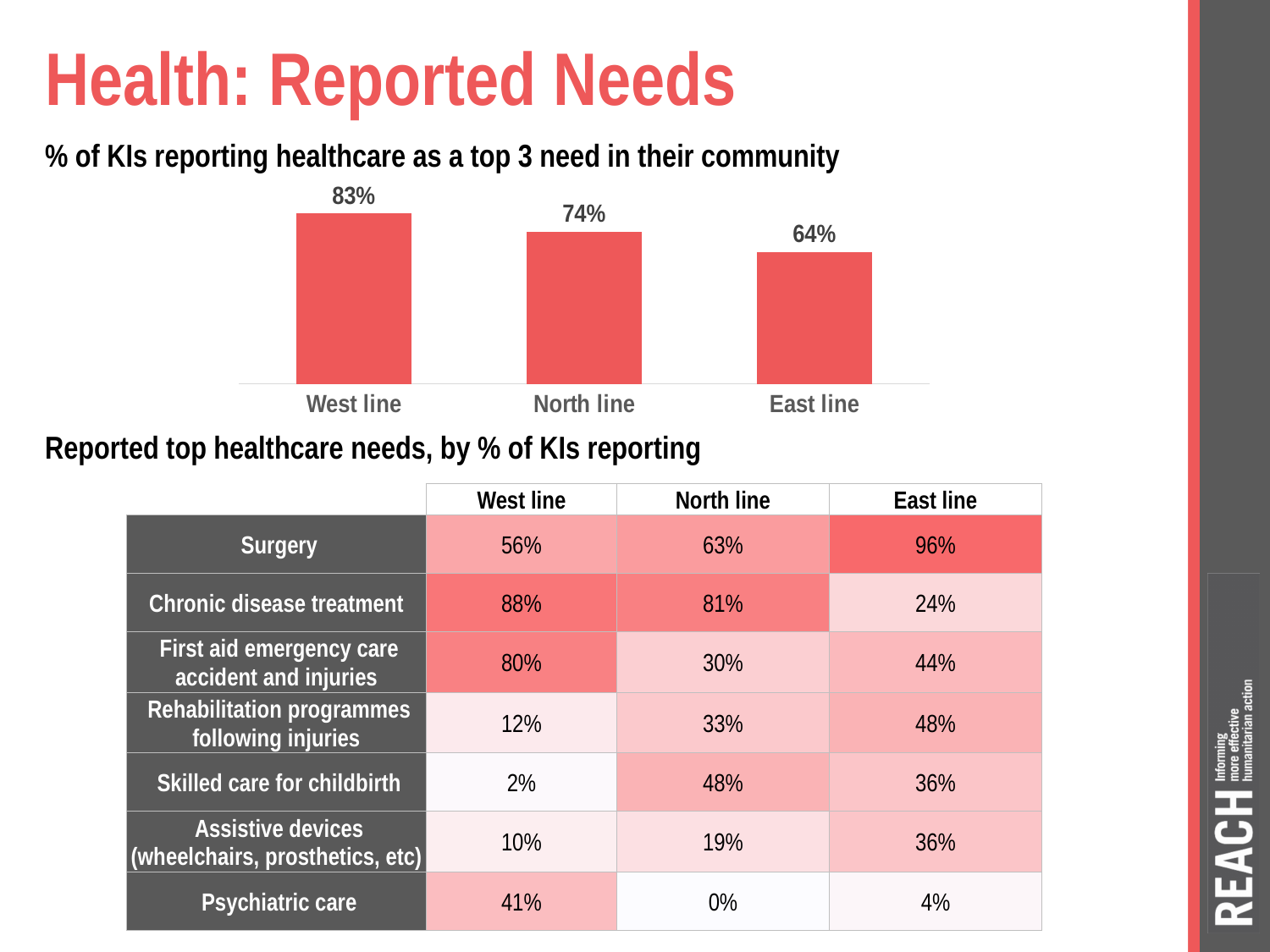
What is the difference between the West line and East line values in the bar chart? 19% What is the difference between the North line and East line values in the bar chart? 10% What is the value for East line in the bar chart? 64% Do the values in the bar chart rise or fall from West line to East line? Fall What type of chart is used to show the % of KIs reporting healthcare as a top 3 need? Bar chart Which line has the highest % of KIs reporting healthcare as a top 3 need? West line What is the value for North line in the bar chart? 74% Which line has the lowest % of KIs reporting healthcare as a top 3 need? East line Which is larger in the bar chart, the value for North line or the value for East line? North line What is the title of the bar chart? % of KIs reporting healthcare as a top 3 need in their community What is the value for West line in the bar chart? 83% How many categories are shown in the bar chart? 3